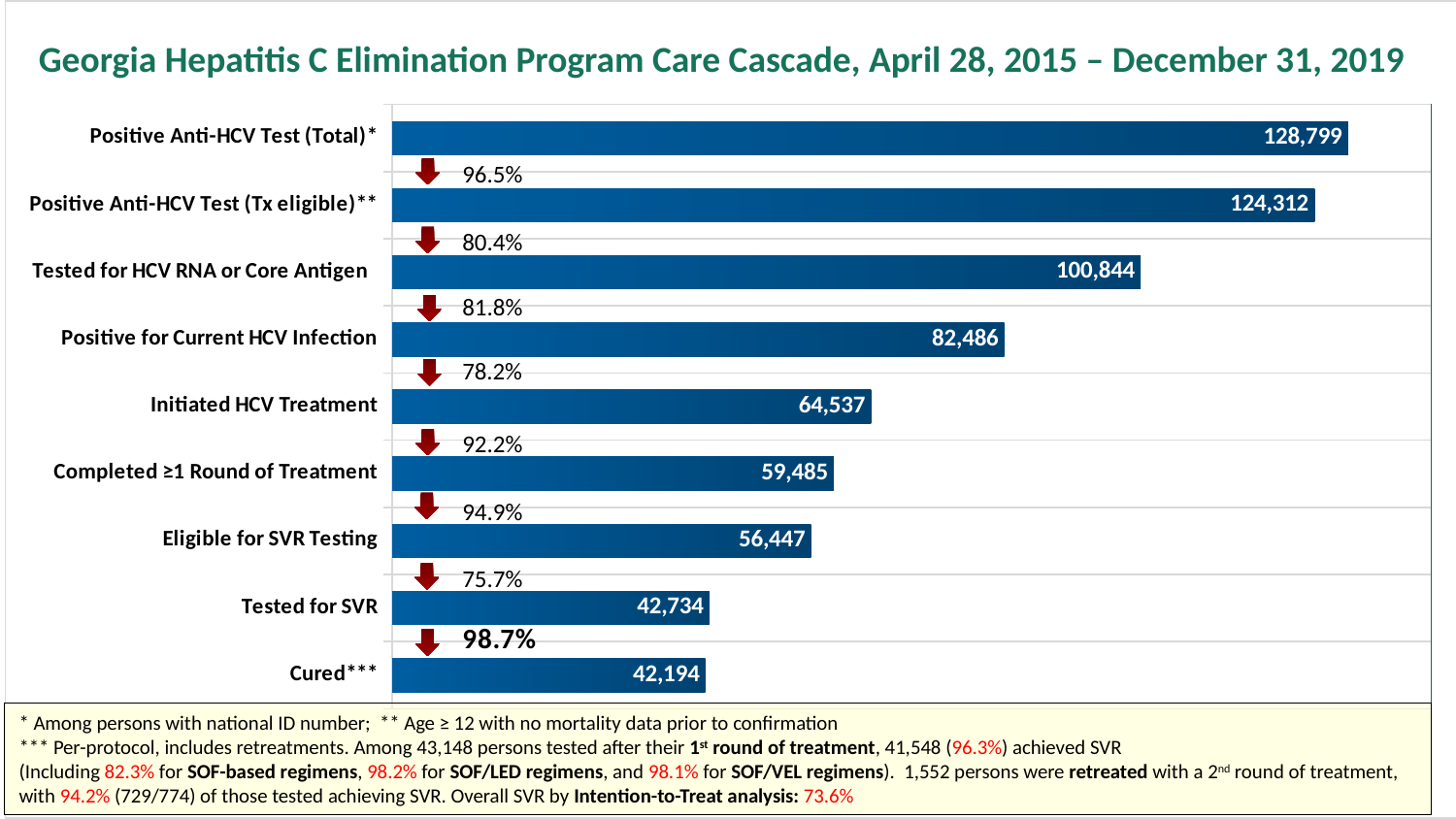
Which category has the lowest value? Cured Which is larger, Completed ≥1 Round of Treatment or Eligible for SVR Testing? Completed ≥1 Round of Treatment What is the difference between Tested for SVR and Cured? 540 What is the difference between Positive for Current HCV Infection and Initiated HCV Treatment? 17,949 How many categories are shown in the chart? 9 What is the value for Positive Anti-HCV Test (Total)? 128,799 Which category has the highest value? Positive Anti-HCV Test (Total) What percentage is shown between Tested for SVR and Cured? 98.7% What is the value for Cured? 42,194 What is the value for Tested for HCV RNA or Core Antigen? 100,844 What is the value for Initiated HCV Treatment? 64,537 What kind of chart is this? Bar chart